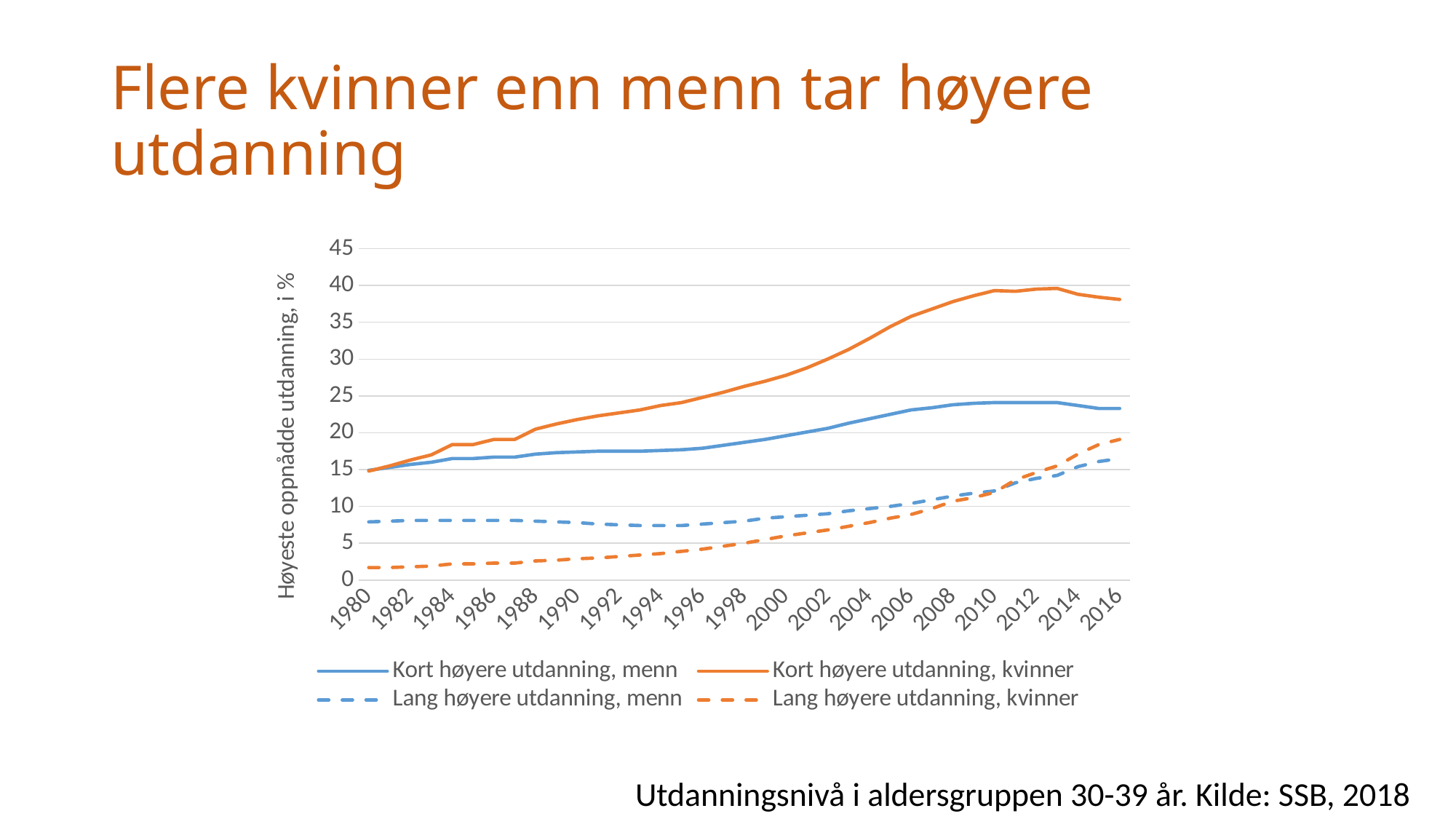
Is the value for 'Lang høyere utdanning, menn' in 1980 greater or less than 5? greater How many year labels are shown on the x axis? 19 Is the value for 'Kort høyere utdanning, kvinner' in 2016 greater or less than 35? greater Is the value for 'Kort høyere utdanning, menn' in 2016 greater or less than 20? greater What is the label on the y axis? Høyeste oppnådde utdanning, i % In 2016, which is larger: 'Kort høyere utdanning, kvinner' or 'Kort høyere utdanning, menn'? Kort høyere utdanning, kvinner What kind of chart is shown on the slide? Line chart Does the line for 'Lang høyere utdanning, kvinner' rise or fall from 1980 to 2016? Rise Which series are drawn with dashed lines? Lang høyere utdanning, menn and Lang høyere utdanning, kvinner In 1980, which is larger: 'Lang høyere utdanning, menn' or 'Lang høyere utdanning, kvinner'? Lang høyere utdanning, menn How many series does the legend list? 4